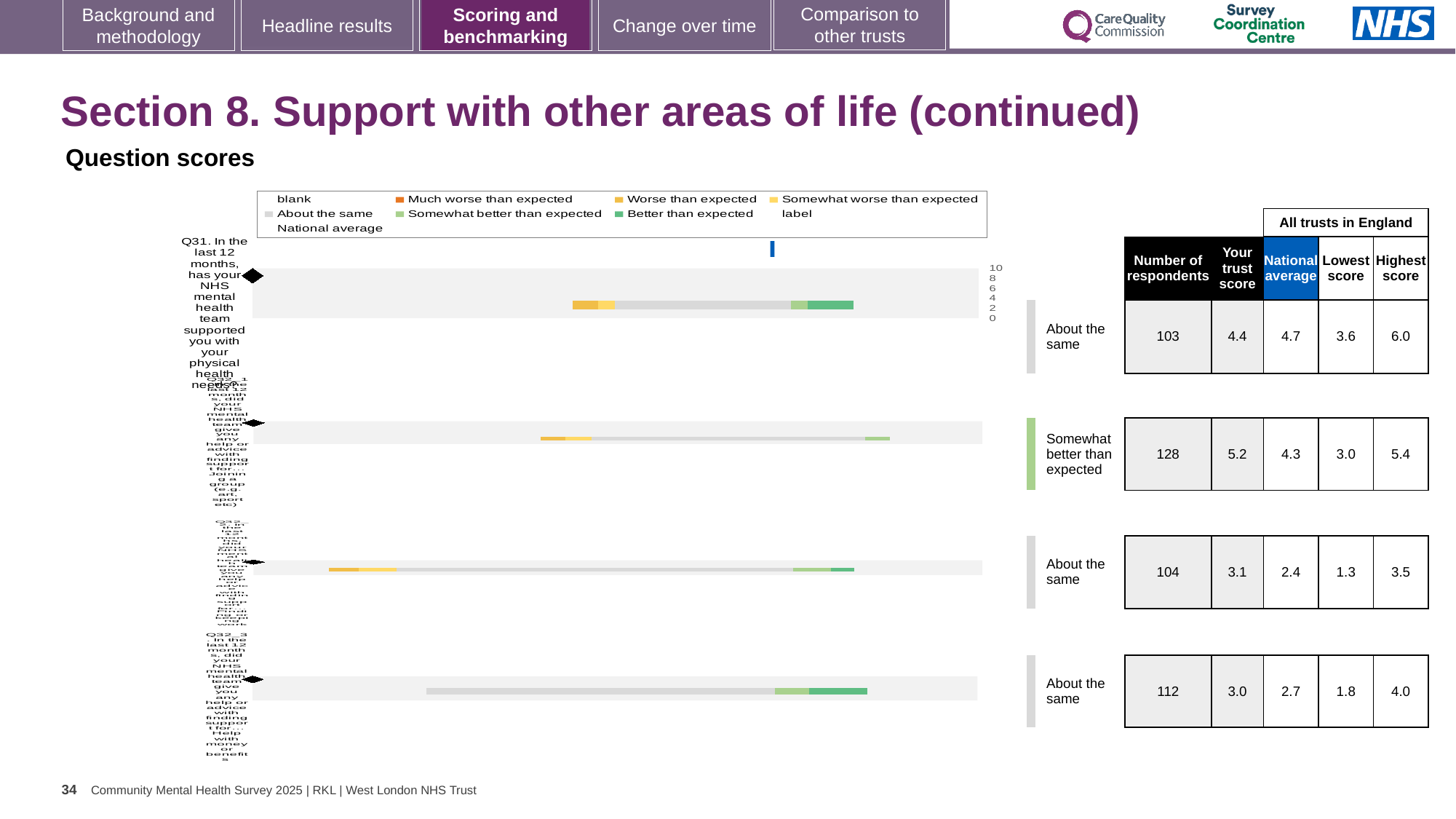
What is the highest score for the fourth (bottom) row? 4.0 For the second row, which is larger: the trust score or the national average? the trust score (5.2) How many respondents are listed for Q31 (the first row)? 103 What is the national average for Q31 (the first row)? 4.7 Which row has the highest trust score? the second row (5.2) What is the trust score for Q31 (the first row)? 4.4 How many respondents are listed for the fourth (bottom) row? 112 What kind of chart is shown on the slide? bar chart How many question bars are plotted in the chart? 4 Which row is rated 'Somewhat better than expected'? the second row What is the lowest score for the third row? 1.3 What is the difference between the highest score and the lowest score for Q31 (the first row)? 2.4